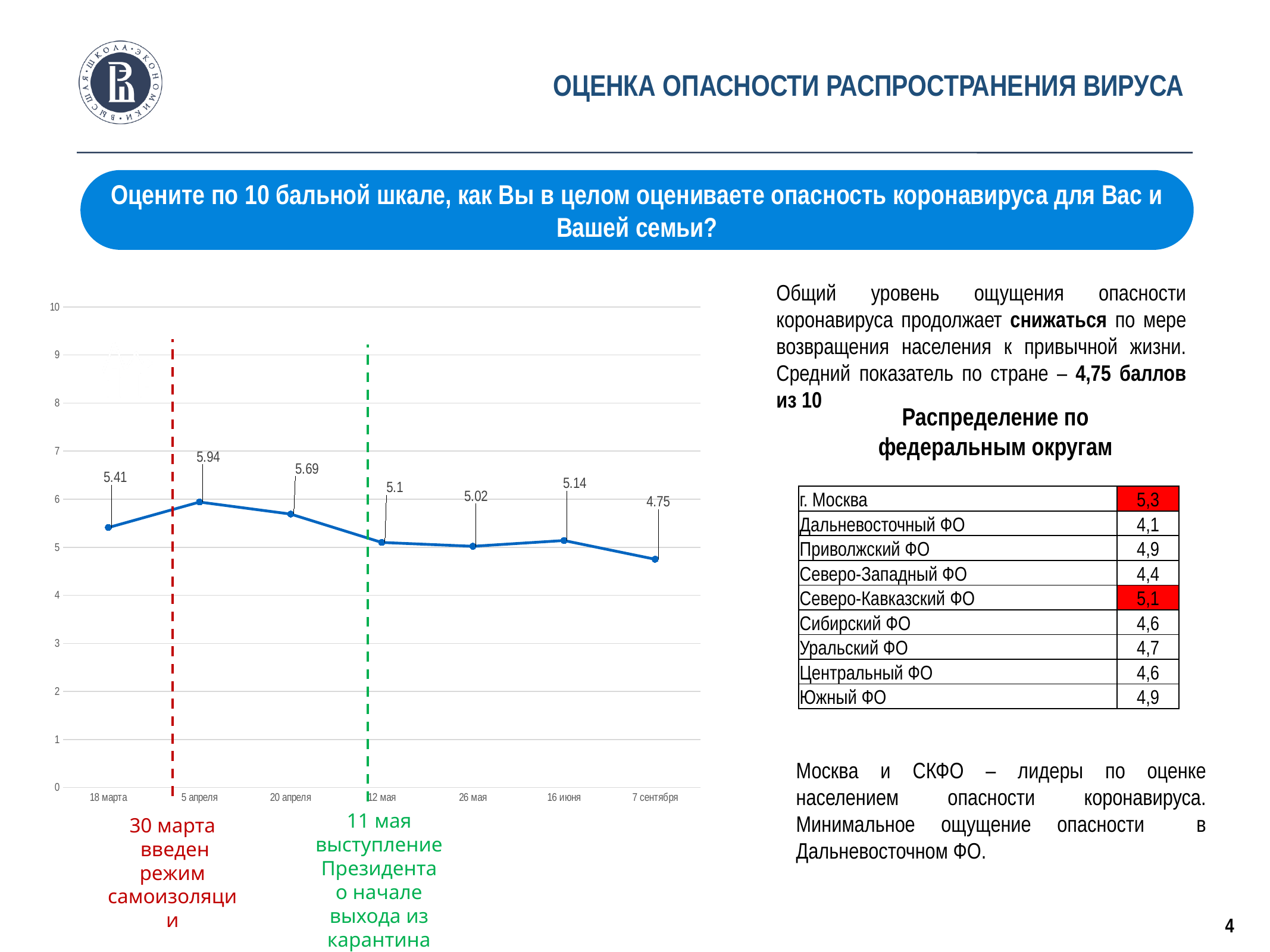
Which is larger on the line chart: the value for 20 апреля or the value for 12 мая? 20 апреля What is the value for 7 сентября on the line chart? 4.75 What is the maximum value shown on the y axis of the line chart? 10 Is the value for 16 июня on the line chart greater or less than 6? less Which date has the highest value on the line chart? 5 апреля What is the value for 18 марта on the line chart? 5.41 What kind of chart is shown on the left of the slide? line chart How many data points are plotted on the line chart? 7 Does the value on the line chart rise or fall from 12 мая to 26 мая? fall What is the value for 26 мая on the line chart? 5.02 What is the difference between the values for 5 апреля and 7 сентября on the line chart? 1.19 Which date has the lowest value on the line chart? 7 сентября